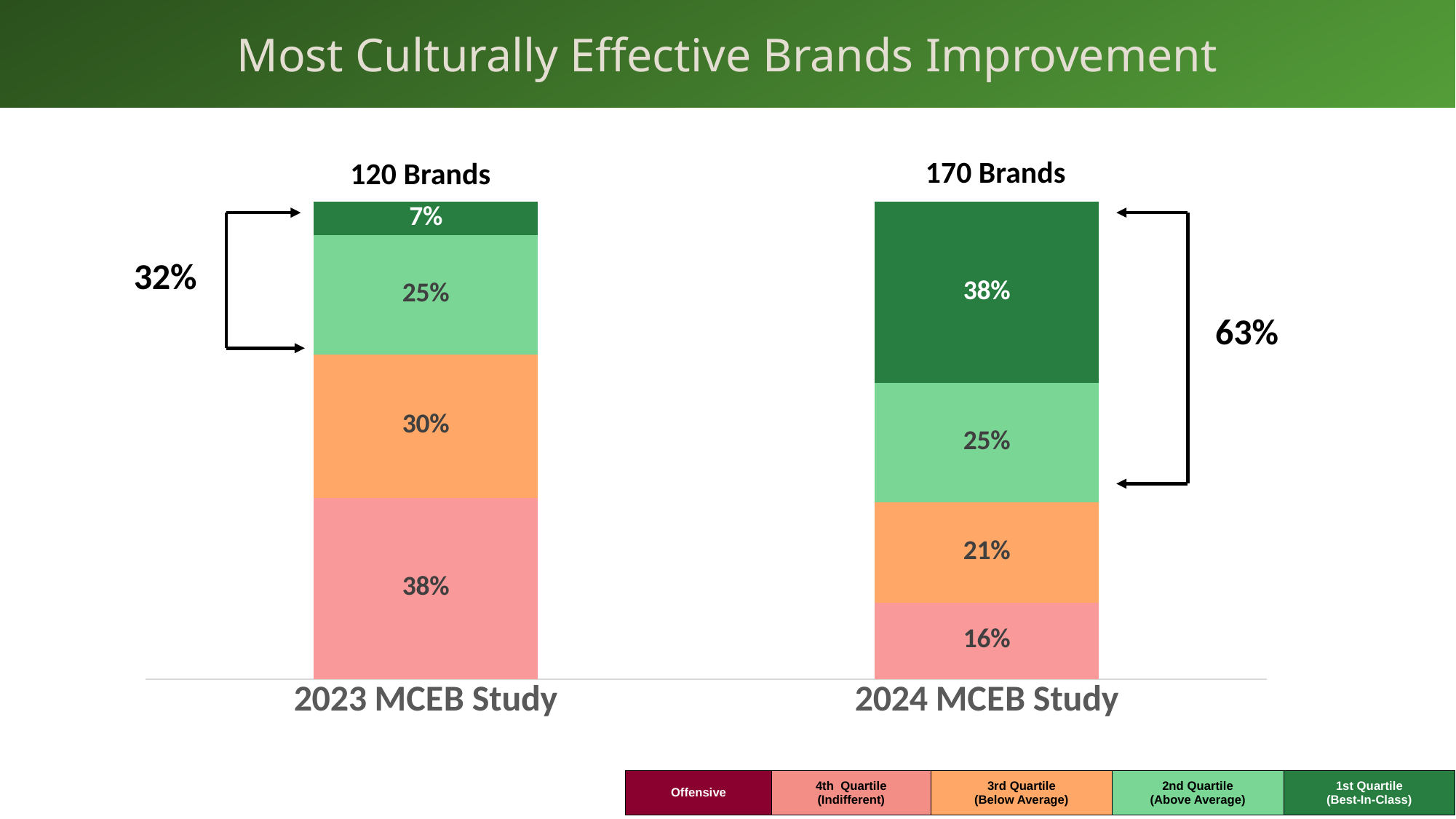
What is the value for the 1st Quartile (Best-In-Class) segment in the 2024 MCEB Study bar? 38% How many bars (study years) are plotted in the chart? 2 What is the value for the 3rd Quartile (Below Average) segment in the 2023 MCEB Study bar? 30% How many brands are noted above the 2024 MCEB Study bar? 170 Brands What is the value for the 4th Quartile (Indifferent) segment in the 2024 MCEB Study bar? 16% Which segment is the largest in the 2023 MCEB Study bar? 4th Quartile (Indifferent) How many entries does the legend list? 5 Which segment is the smallest in the 2024 MCEB Study bar? 4th Quartile (Indifferent) What is the value for the 1st Quartile (Best-In-Class) segment in the 2023 MCEB Study bar? 7% What kind of chart is shown on the slide? Stacked bar chart Which bar has the larger 3rd Quartile (Below Average) segment, 2023 MCEB Study or 2024 MCEB Study? 2023 MCEB Study What is the difference between the 1st Quartile (Best-In-Class) values for the 2024 and 2023 MCEB Studies? 31%